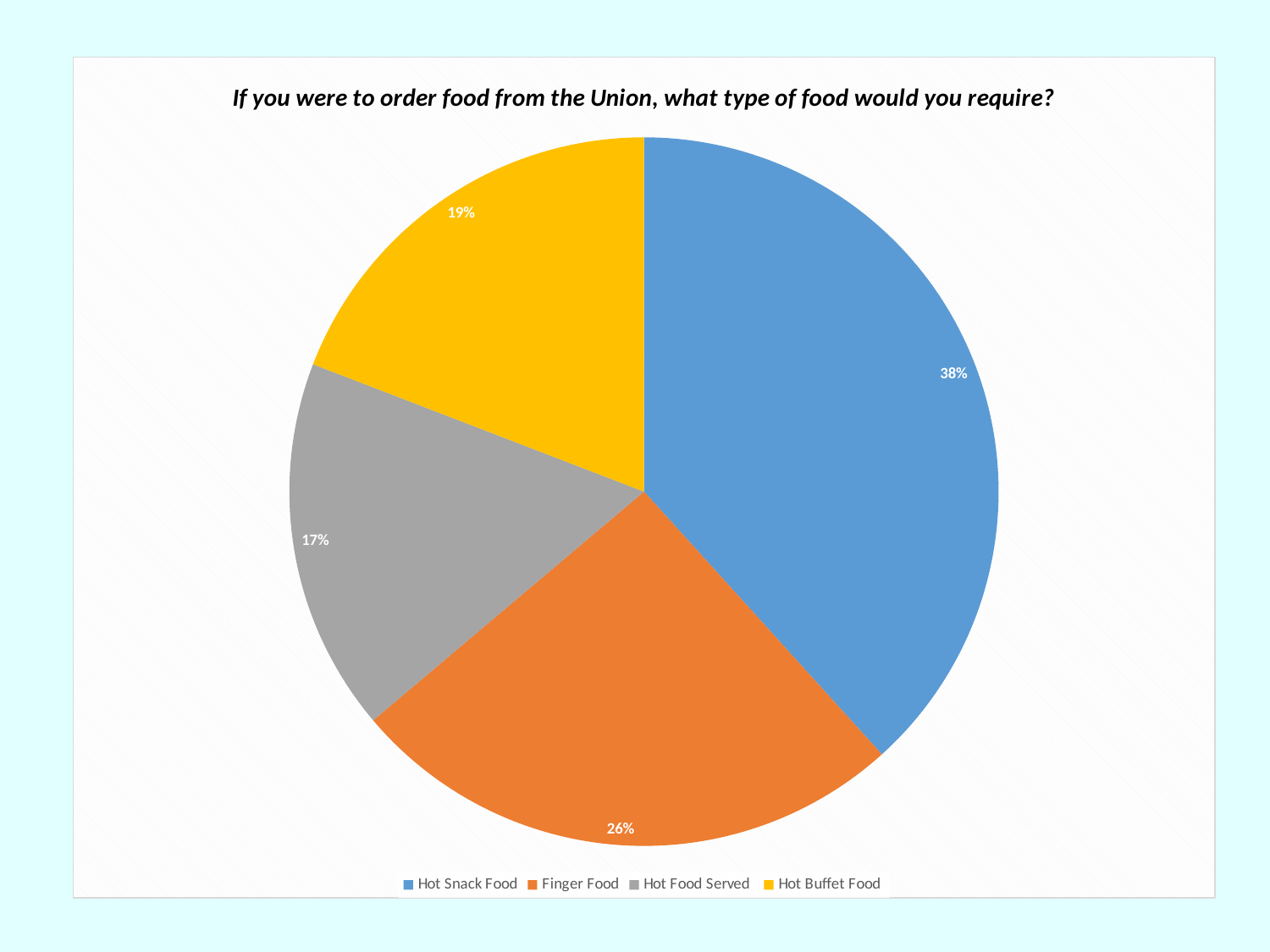
What colour is the Finger Food slice? Orange Which food type has the largest slice of the pie? Hot Snack Food Which is larger, the share for Hot Buffet Food or the share for Hot Food Served? Hot Buffet Food What share of the pie does Finger Food have? 26% What is the difference in percentage points between Hot Snack Food and Finger Food? 12 What share of the pie does Hot Food Served have? 17% What is the title of the chart? If you were to order food from the Union, what type of food would you require? What share of the pie does Hot Snack Food have? 38% How many categories are shown in the pie chart? 4 Which food type has the smallest slice of the pie? Hot Food Served What kind of chart is shown on the slide? Pie chart